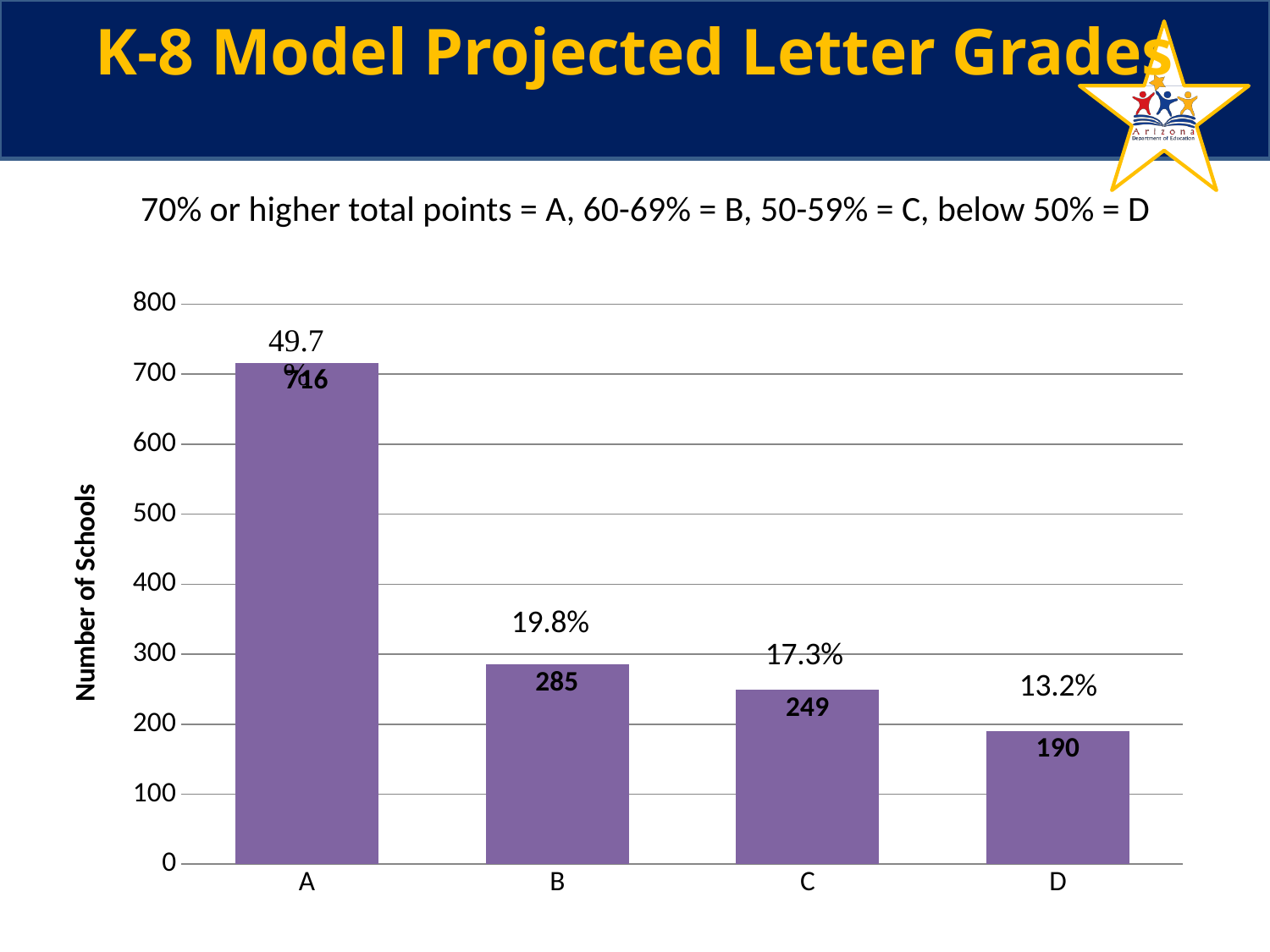
Which letter grade has the lowest number of schools? D What is the label of the y axis? Number of Schools How many schools are projected to receive a C grade? 249 How many letter grade categories are shown on the x axis? 4 What is the difference in the number of schools between grade B and grade C? 36 What percentage of schools are projected to receive a D grade? 13.2% Which letter grade has the highest number of schools? A Is the number of schools with grade A greater or less than 700? greater How many schools are projected to receive a B grade? 285 What percentage of schools are projected to receive a B grade? 19.8% How many schools are projected to receive a D grade? 190 Which has more schools, grade C or grade D? C